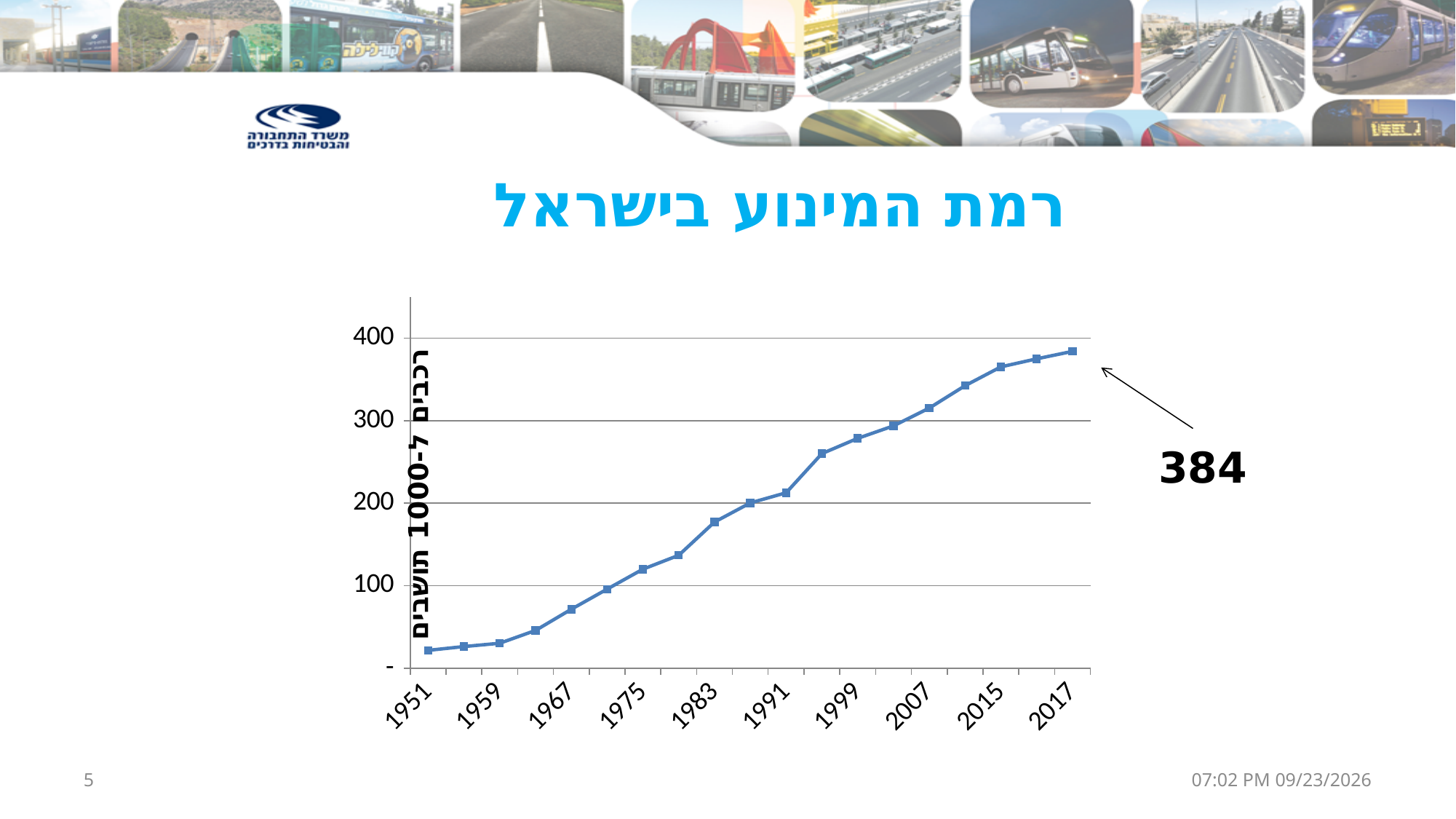
What is the value for 2017 according to the annotation on the chart? 384 Do the values rise or fall along the x axis from 1951 to 2017? rise Is the value for 1951 greater or less than 100? less Is the value for 1999 greater or less than 200? greater Which year has the highest value on the chart? 2017 What is the title of the chart on the slide? רמת המינוע בישראל Is the value for 1967 greater or less than 100? less Which year has the larger value, 1983 or 1991? 1991 What kind of chart is shown on the slide? line chart Which year has the lowest value on the chart? 1951